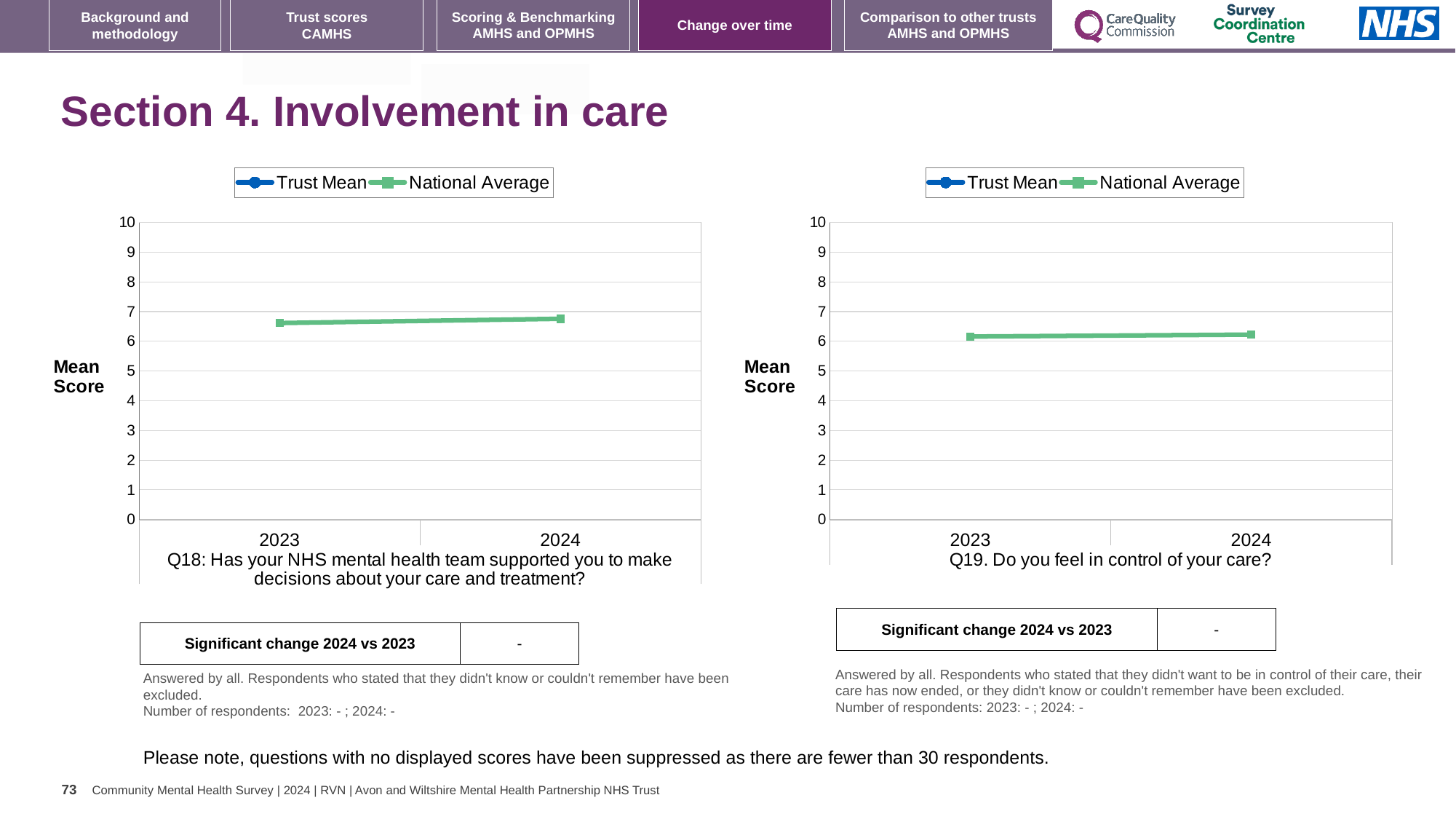
What is the maximum value shown on the y axis of the Q18 chart? 10 How many series does the legend of the Q18 chart list? 2 In the Q18 chart, is the National Average value for 2024 greater or less than 7? less What kind of chart is the Q19 chart on the right? line chart In the Q18 chart, does the National Average line rise or fall from 2023 to 2024? rise How many years are shown on the x axis of the Q19 chart? 2 Which series in the Q18 chart's legend is shown in green? National Average What kind of chart is the Q18 chart on the left? line chart What is the label of the y axis on the Q19 chart? Mean Score In the Q19 chart, is the National Average value for 2024 greater or less than 5? greater In the Q18 chart, is the National Average value for 2023 greater or less than 6? greater